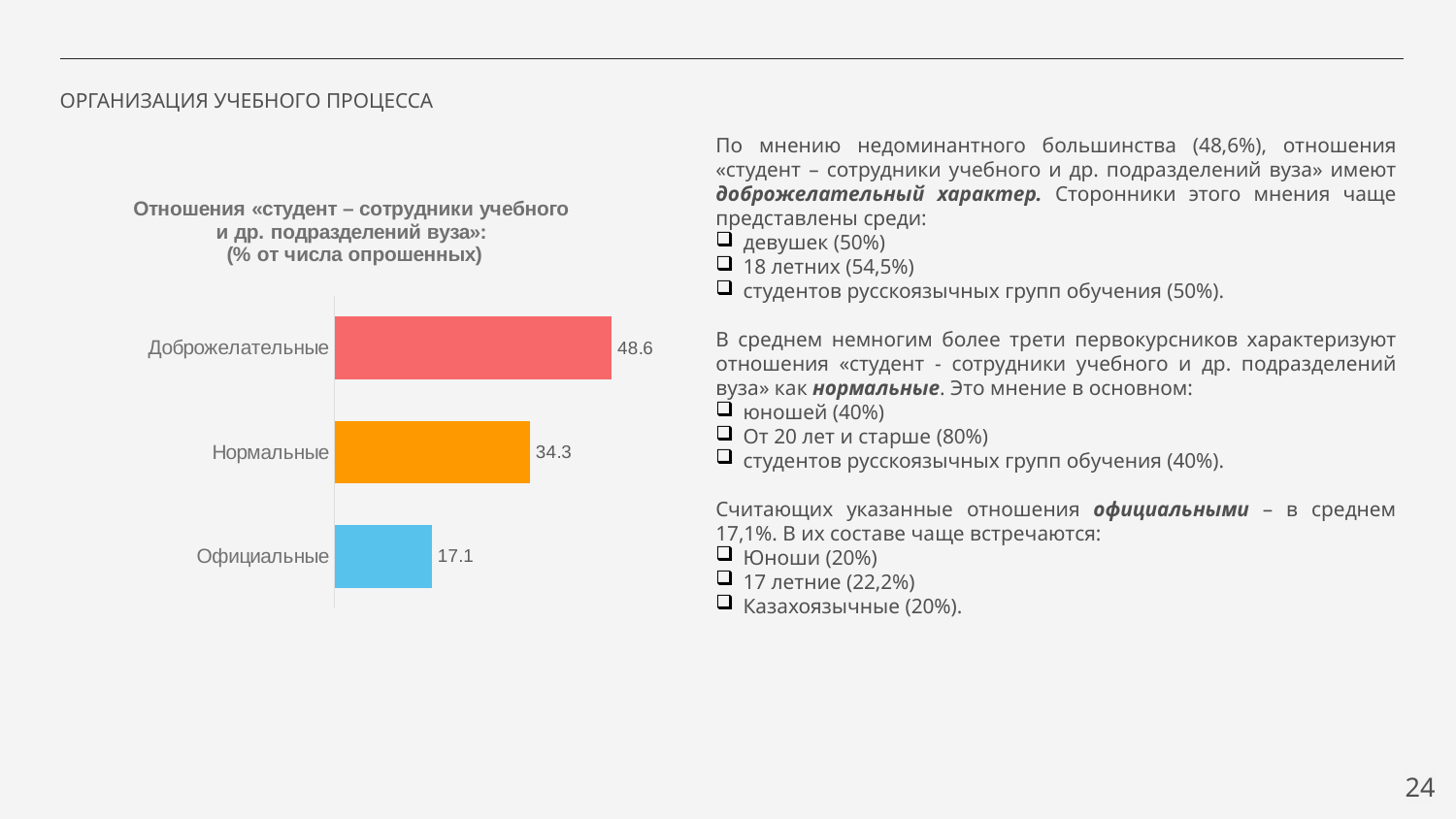
What is the value for Официальные? 17.1 Which is larger, the value for Нормальные or the value for Официальные? Нормальные What is the difference between the values for Доброжелательные and Нормальные? 14.3 What colour is the bar for Официальные? Light blue What kind of chart is shown on the slide? Bar chart What is the title of the chart? Отношения «студент – сотрудники учебного и др. подразделений вуза»: (% от числа опрошенных) How many categories are shown in the chart? 3 Which category has the lowest value? Официальные What is the value for Нормальные? 34.3 What is the difference between the values for Нормальные and Официальные? 17.2 What is the value for Доброжелательные? 48.6 Which category has the highest value? Доброжелательные